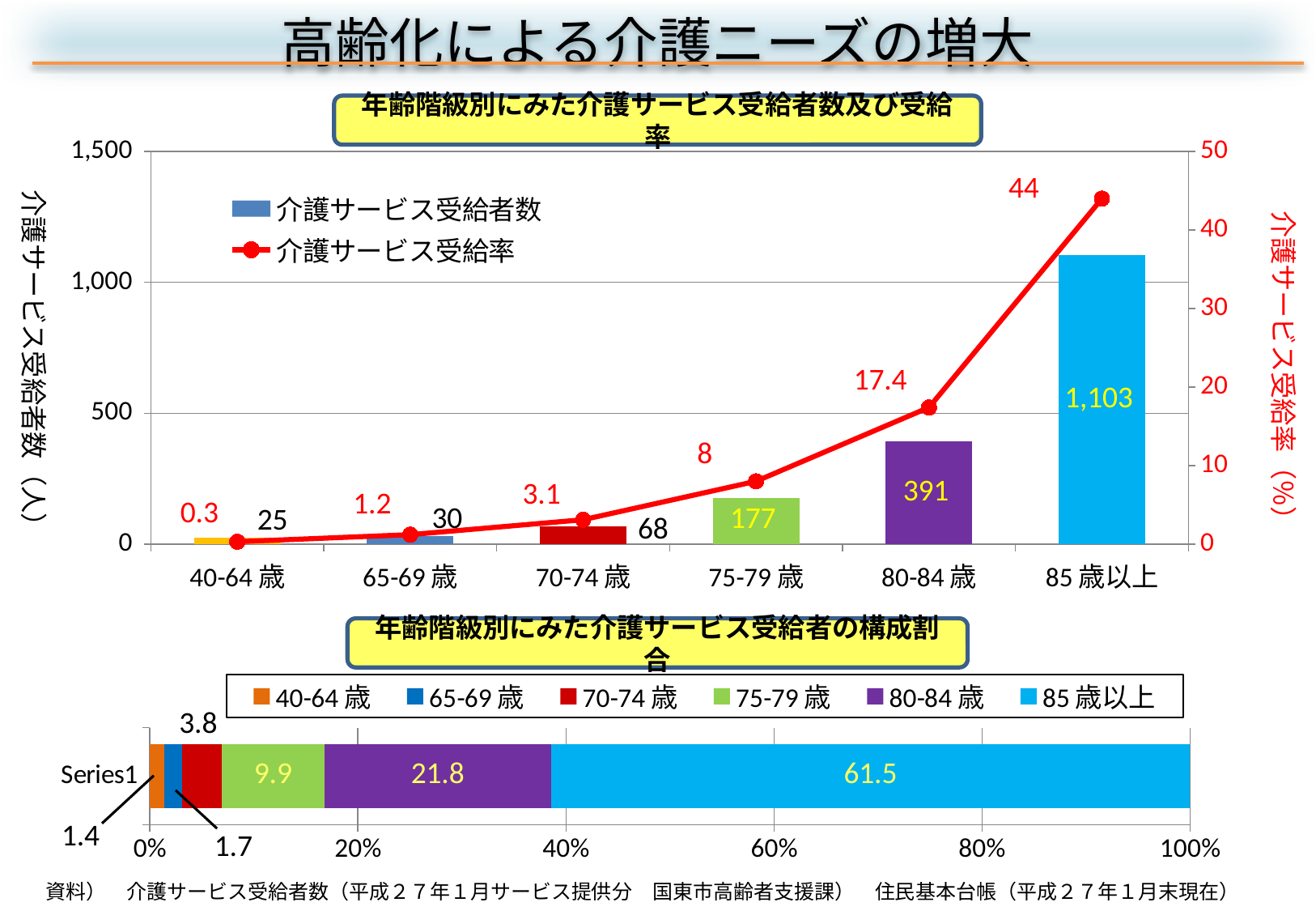
In the bottom chart, what is the share for 70-74歳? 3.8 In the top chart, how many series does the legend list? 2 In the top chart, what is the difference in 介護サービス受給者数 between 80-84歳 and 75-79歳? 214 In the top chart, which is larger: the 介護サービス受給者数 for 70-74歳 or for 65-69歳? 70-74歳 What kind of chart is the bottom chart? stacked bar chart In the top chart (年齢階級別にみた介護サービス受給者数及び受給率), what is the 介護サービス受給者数 for 85歳以上? 1,103 In the top chart, which age group has the highest 介護サービス受給率? 85歳以上 In the top chart, how many age groups are shown on the x axis? 6 In the top chart, which age group has the lowest 介護サービス受給者数? 40-64歳 In the bottom chart (年齢階級別にみた介護サービス受給者の構成割合), what is the share for 85歳以上? 61.5 In the top chart, does the 介護サービス受給率 rise or fall as age increases along the x axis? rise In the top chart, what is the 介護サービス受給率 for 80-84歳? 17.4